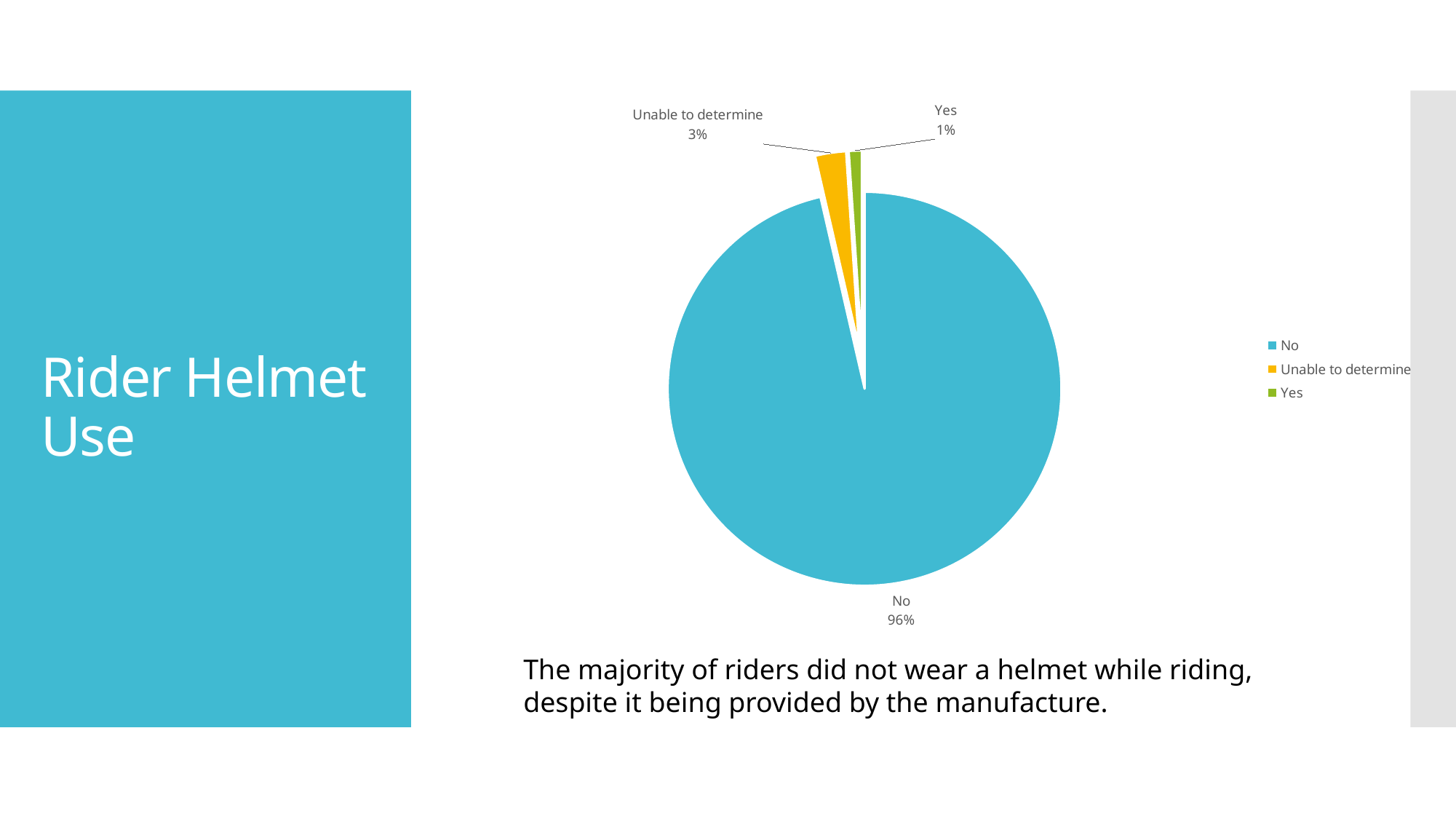
How many slices does the pie chart have? 3 What is the title of the slide containing the pie chart? Rider Helmet Use What percentage is shown for the "Yes" slice? 1% Which is larger, the "Unable to determine" slice or the "Yes" slice? Unable to determine Which category has the largest share of the pie? No Which category has the smallest share of the pie? Yes How many entries does the legend list? 3 What is the difference in percentage points between the "No" slice and the "Unable to determine" slice? 93 What percentage of riders did not wear a helmet (the "No" slice)? 96% What colour is the "No" slice in the pie chart? blue What percentage is shown for the "Unable to determine" slice? 3% What kind of chart is shown on the slide? pie chart